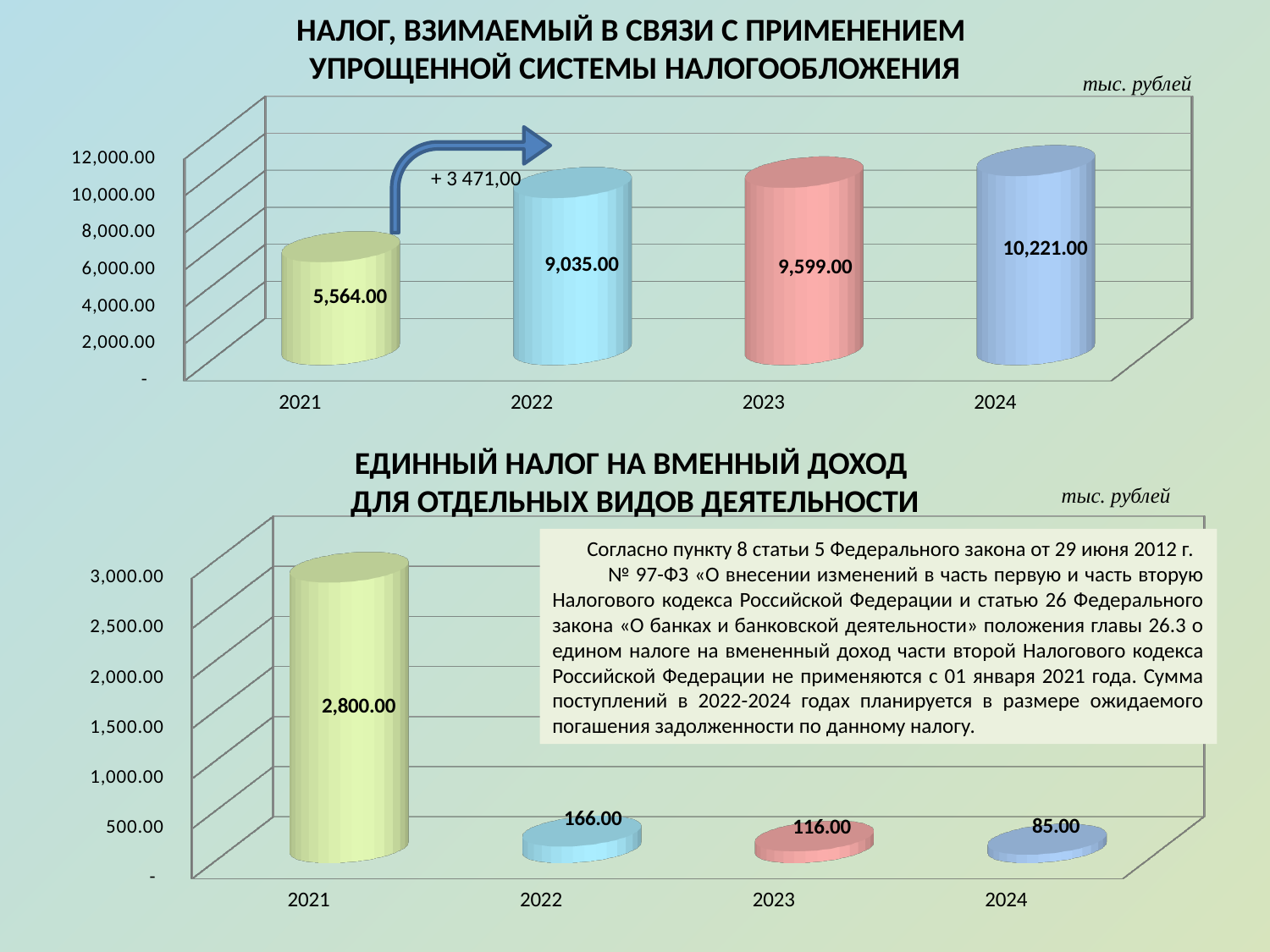
In the bottom chart, how many years are plotted? 4 In the top chart, which year has the highest value? 2024 In the bottom chart, what is the value for 2023? 116.00 In the bottom chart, which year has the lowest value? 2024 In the top chart, do the values rise or fall from 2021 to 2024? rise In the top chart, what is the value for 2024? 10,221.00 In the top chart, what is the difference between the 2022 and 2021 values? 3,471.00 In the bottom chart, what is the difference between the 2022 and 2023 values? 50.00 In the bottom chart, which is larger, the value for 2022 or the value for 2024? 2022 In the top chart, what is the value for 2021? 5,564.00 In the bottom chart, what is the value for 2021? 2,800.00 In the top chart, what type of chart is shown? bar chart